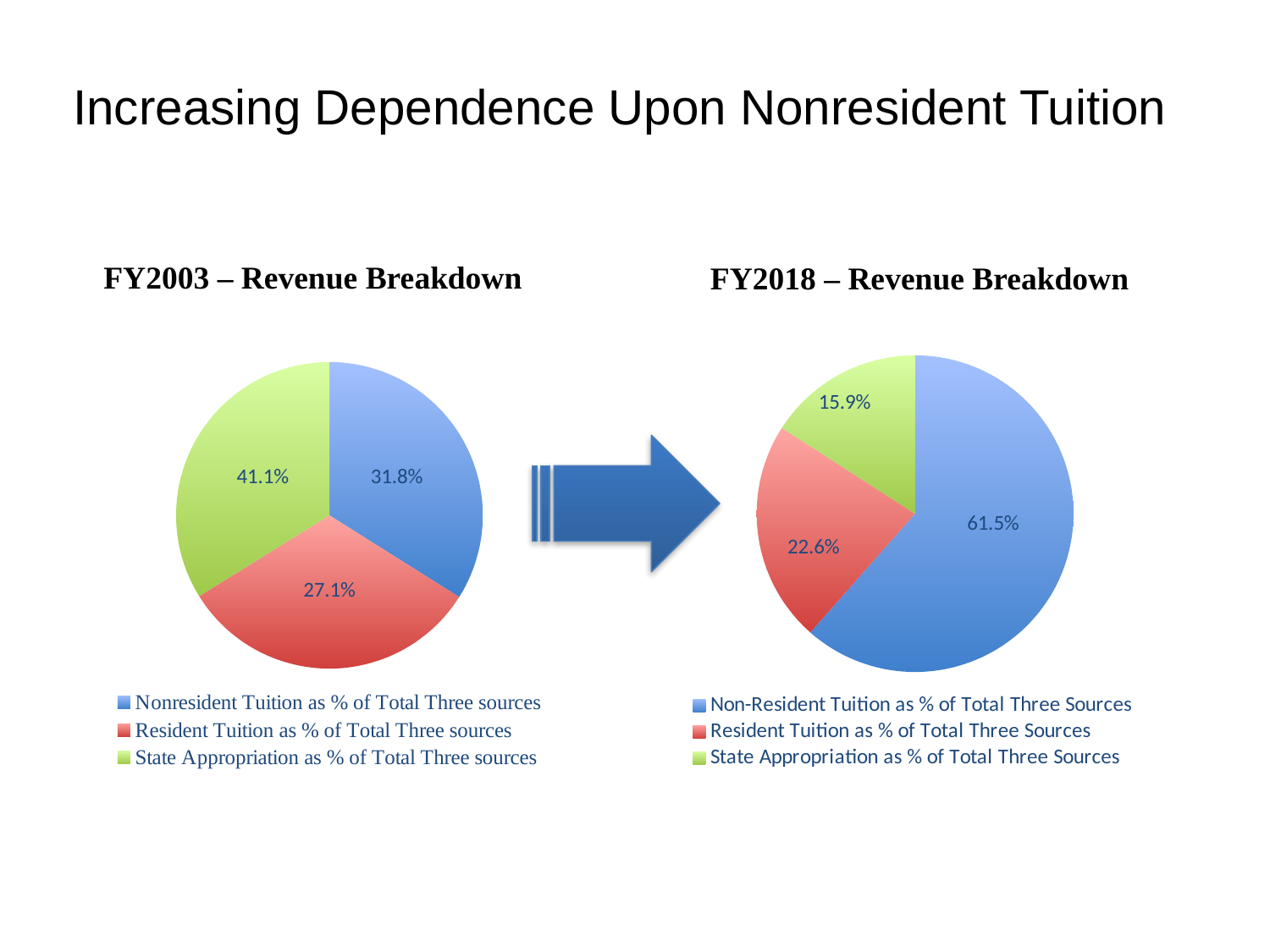
How many slices does the FY2018 – Revenue Breakdown pie chart have? 3 In the FY2018 – Revenue Breakdown chart, what is the value for Non-Resident Tuition as % of Total Three Sources? 61.5% In the FY2003 – Revenue Breakdown chart, what is the value for State Appropriation as % of Total Three sources? 41.1% In the FY2003 – Revenue Breakdown chart, which is larger: Nonresident Tuition or Resident Tuition? Nonresident Tuition In the FY2003 – Revenue Breakdown chart, which category has the smallest share? Resident Tuition as % of Total Three sources In the FY2018 – Revenue Breakdown chart, what is the difference between the Non-Resident Tuition share and the Resident Tuition share? 38.9% In the FY2003 – Revenue Breakdown chart, which category has the largest share? State Appropriation as % of Total Three sources In the FY2018 – Revenue Breakdown chart, which category has the smallest share? State Appropriation as % of Total Three Sources In the FY2018 – Revenue Breakdown chart, what colour is the Resident Tuition slice? Red In the FY2018 – Revenue Breakdown chart, what is the value for State Appropriation as % of Total Three Sources? 15.9% What kind of chart is the FY2003 – Revenue Breakdown chart? Pie chart In the FY2003 – Revenue Breakdown chart, what is the value for Resident Tuition as % of Total Three sources? 27.1%